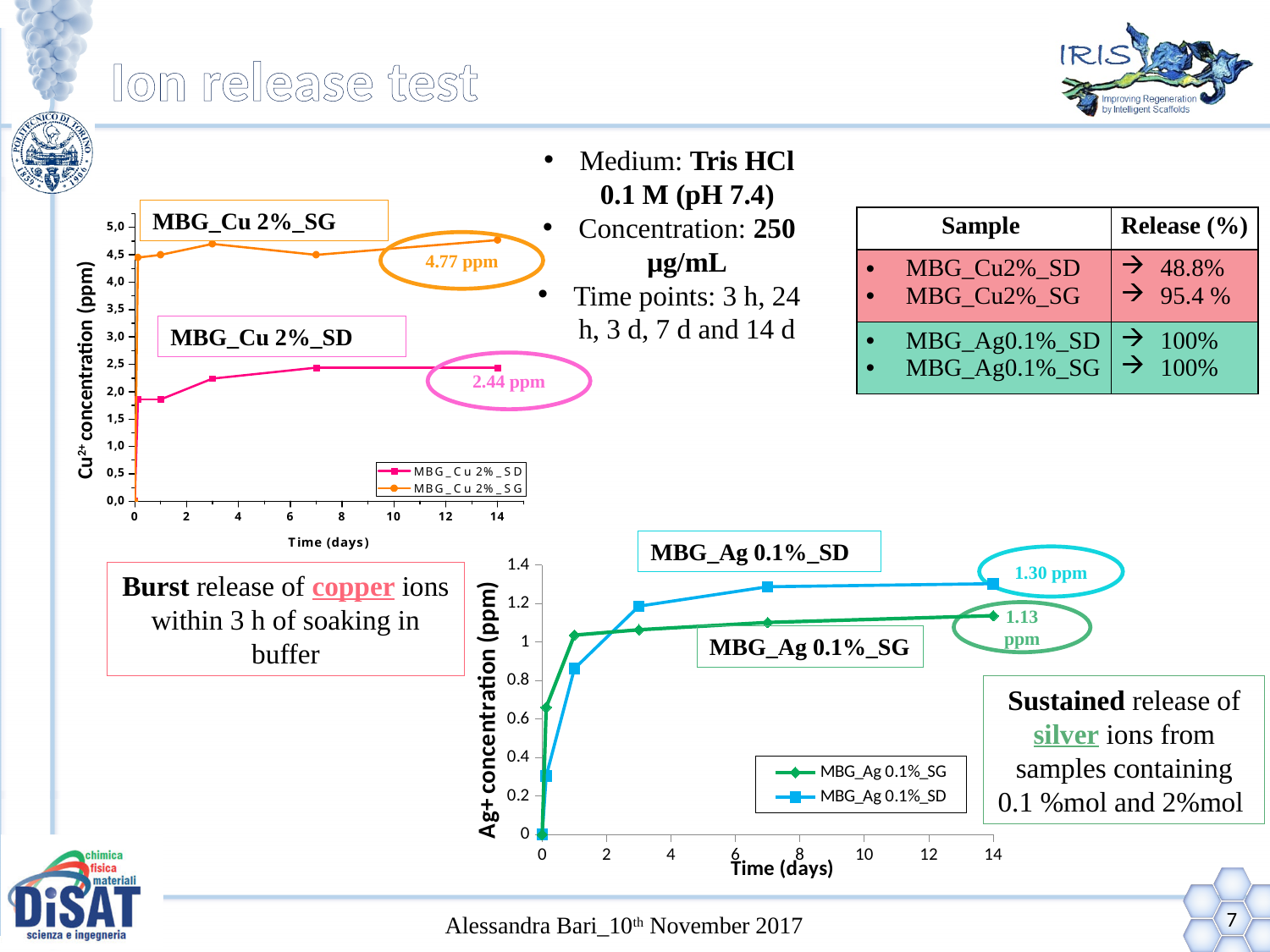
What is the x-axis label on the Ag+ concentration chart? Time (days) On the Cu2+ concentration chart, what is the final value labelled for MBG_Cu 2%_SG? 4.77 ppm On the Ag+ concentration chart, is the value for MBG_Ag 0.1%_SD at 14 days greater or less than 1.2? greater On the Cu2+ concentration chart, which series reaches the higher concentration, MBG_Cu 2%_SG or MBG_Cu 2%_SD? MBG_Cu 2%_SG On the Ag+ concentration chart, what is the final value labelled for MBG_Ag 0.1%_SG? 1.13 ppm On the Cu2+ concentration chart, what is the difference between the labelled final values of MBG_Cu 2%_SG and MBG_Cu 2%_SD? 2.33 ppm On the Ag+ concentration chart, what is the difference between the labelled final values of MBG_Ag 0.1%_SD and MBG_Ag 0.1%_SG? 0.17 ppm On the Cu2+ concentration chart, what is the final value labelled for MBG_Cu 2%_SD? 2.44 ppm On the Ag+ concentration chart, do the Ag+ concentration values rise or fall as time increases? Rise On the Cu2+ concentration chart, how many series does the legend list? 2 On the Ag+ concentration chart, what is the final value labelled for MBG_Ag 0.1%_SD? 1.30 ppm What kind of chart is the Cu2+ concentration chart? Line chart